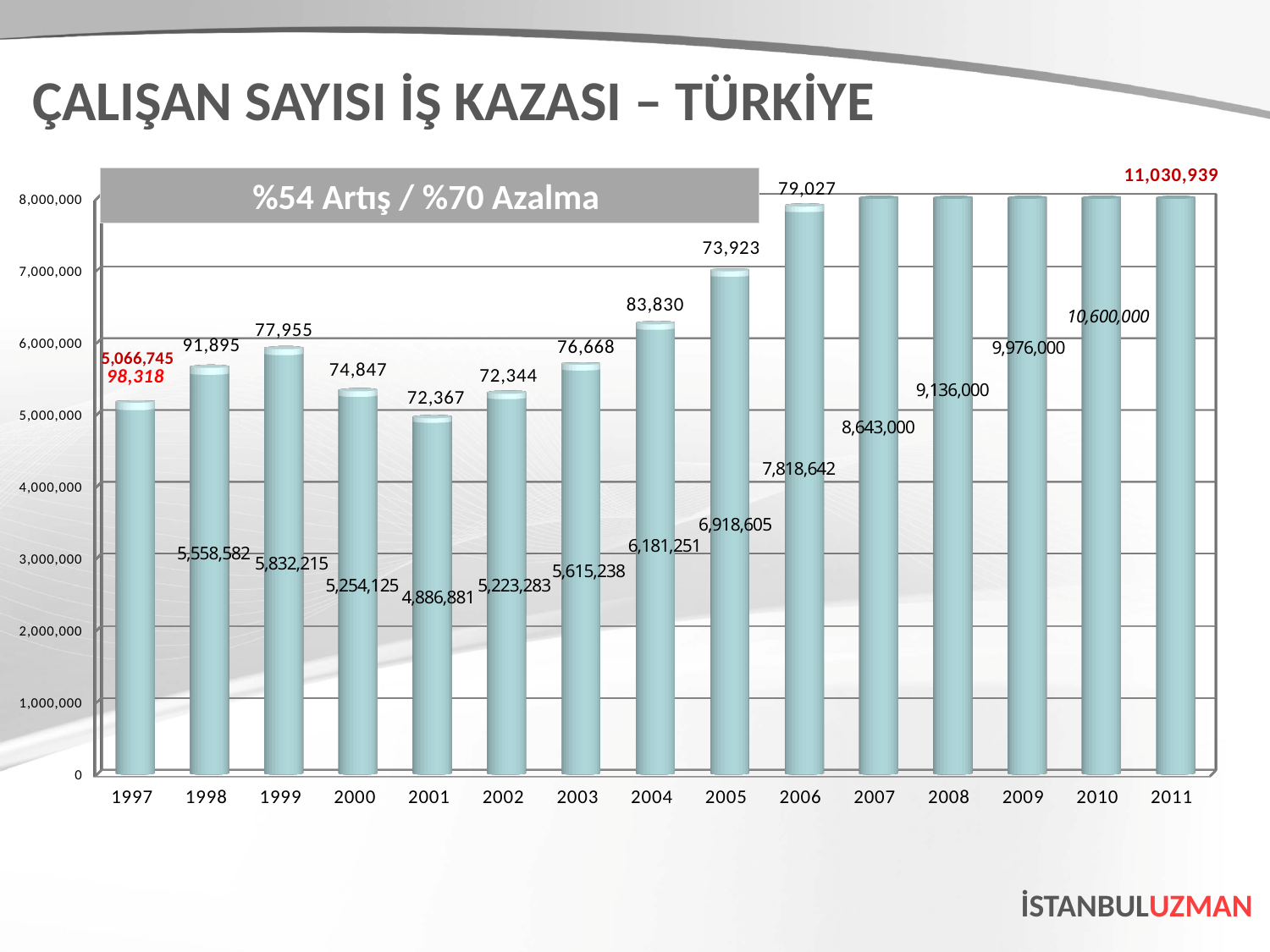
Which year has the highest work accident count label? 1997 What is the difference between the employee count labels for 2011 and 1997? 5,964,194 What is the difference between the work accident labels for 1997 and 2006? 19,291 Which year has the larger employee count label, 2002 or 2003? 2003 What text is written in the grey box at the top of the chart? %54 Artış / %70 Azalma Which year has the lowest employee count label? 2001 What is the work accident count (upper label) shown for 2001? 72,367 What value is shown in red at the top right for 2011? 11,030,939 Is the bar for 2005 greater or less than 6,000,000? greater What is the employee count (lower label) shown for 2004? 6,181,251 How many years are shown on the x axis of the chart? 15 What kind of chart is shown on the slide? bar chart